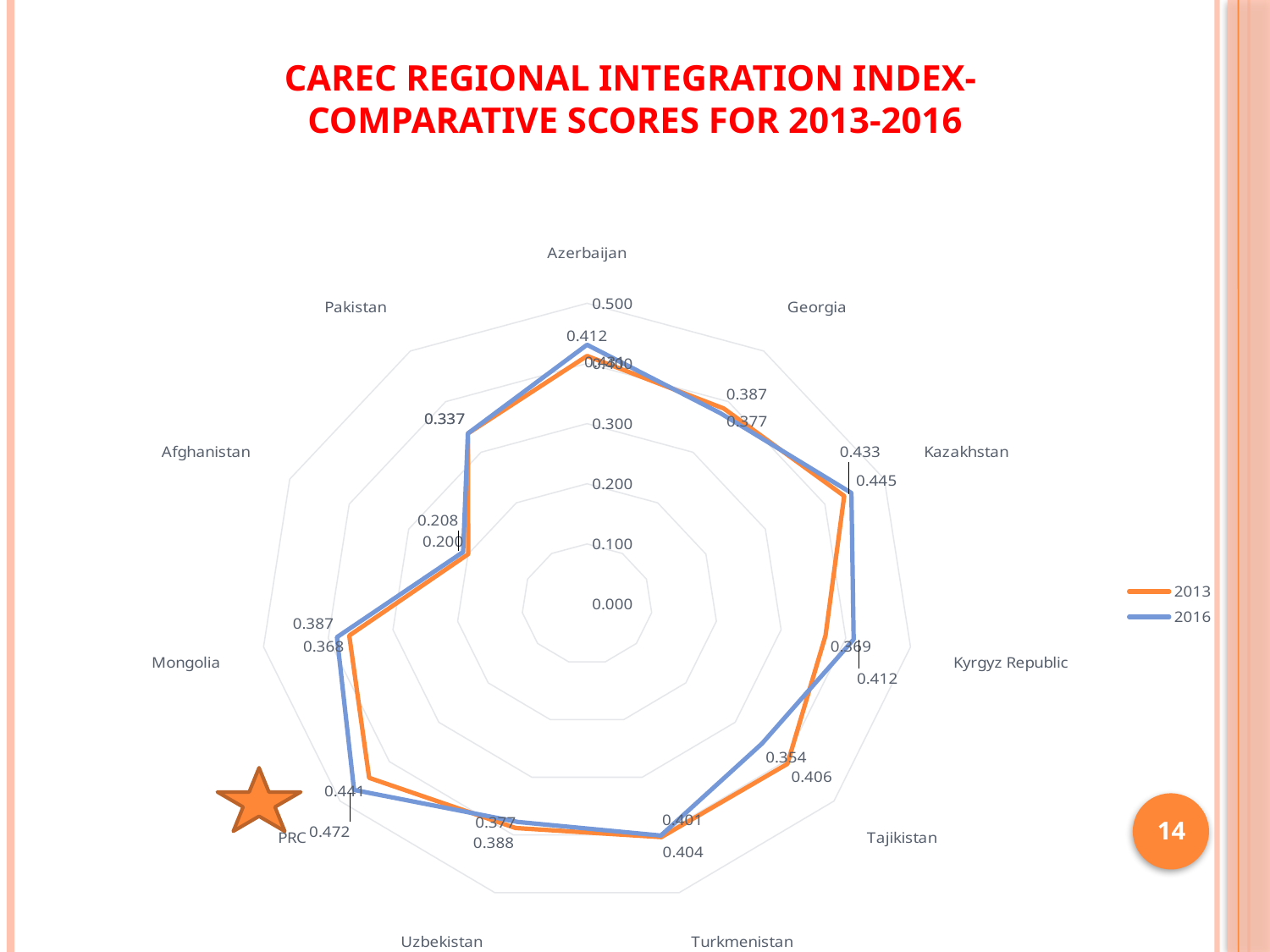
What is the 2016 score for Kazakhstan? 0.445 How many series does the legend list? 2 Which country has the lowest scores on the chart? Afghanistan What is the difference between PRC's 2016 and 2013 scores? 0.031 What are the two scores labelled for Tajikistan? 0.354 and 0.406 How many countries are plotted on the radar chart? 11 What is the 2016 score for PRC? 0.472 Is the score for Afghanistan greater or less than 0.300? less Which country has the highest score on the chart? PRC What kind of chart is shown on the slide? Radar chart Which years are listed in the legend? 2013 and 2016 What is the 2013 score for PRC? 0.441